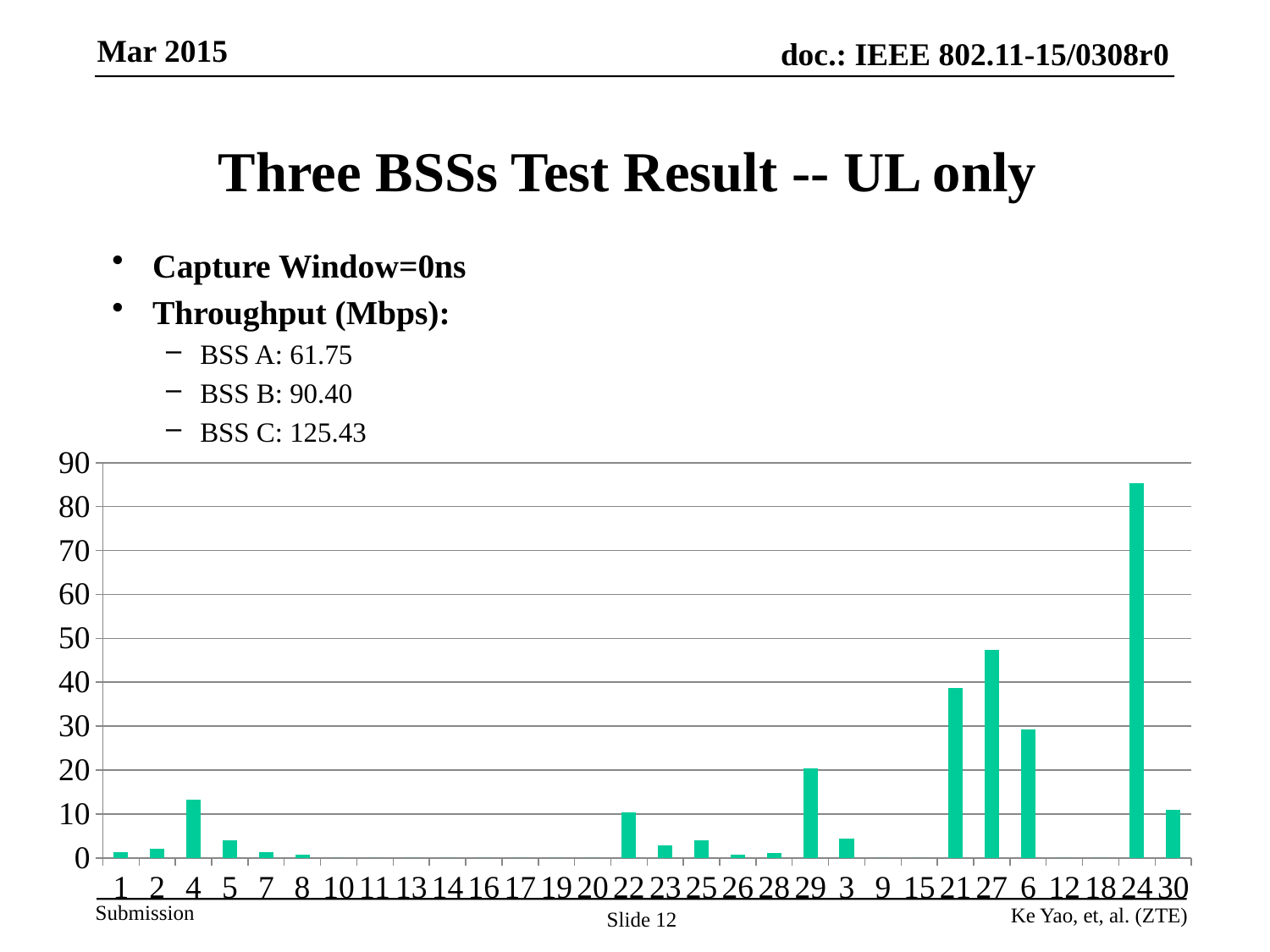
What kind of chart is shown on the slide? bar chart Is the value for category 6 greater or less than 20? greater Is the value for category 27 greater or less than 40? greater Is the value for category 27 greater or less than 50? less How many categories are shown along the x axis of the chart? 30 Which has the larger value, category 24 or category 27? 24 Which category has the tallest bar in the chart? 24 What is the highest tick value shown on the y axis of the chart? 90 Which has the larger value, category 21 or category 6? 21